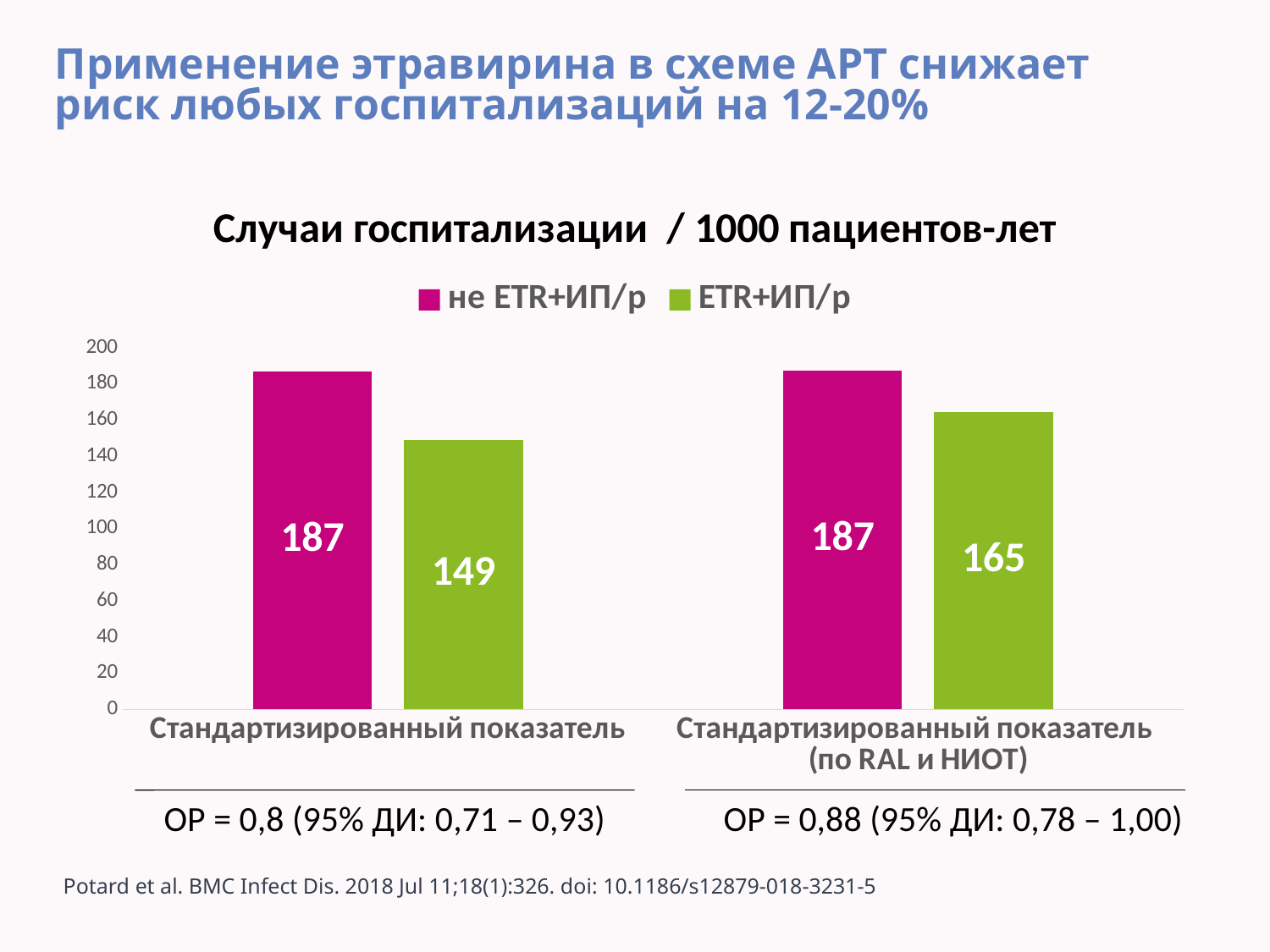
What kind of chart is shown on the slide? Bar chart What is the value for "не ETR+ИП/р" in the "Стандартизированный показатель" category? 187 Which series has the larger value in the "Стандартизированный показатель" category? не ETR+ИП/р What is the difference between the "не ETR+ИП/р" and "ETR+ИП/р" values in the "Стандартизированный показатель" category? 38 What is the value for "ETR+ИП/р" in the "Стандартизированный показатель (по RAL и НИОТ)" category? 165 How many series does the legend list? 2 What is the difference between the "не ETR+ИП/р" and "ETR+ИП/р" values in the "Стандартизированный показатель (по RAL и НИОТ)" category? 22 Which bar has the lowest value on the chart? ETR+ИП/р in Стандартизированный показатель (149) How many categories are shown on the x axis? 2 What is the title of the chart? Случаи госпитализации / 1000 пациентов-лет What is the value for "не ETR+ИП/р" in the "Стандартизированный показатель (по RAL и НИОТ)" category? 187 What is the value for "ETR+ИП/р" in the "Стандартизированный показатель" category? 149